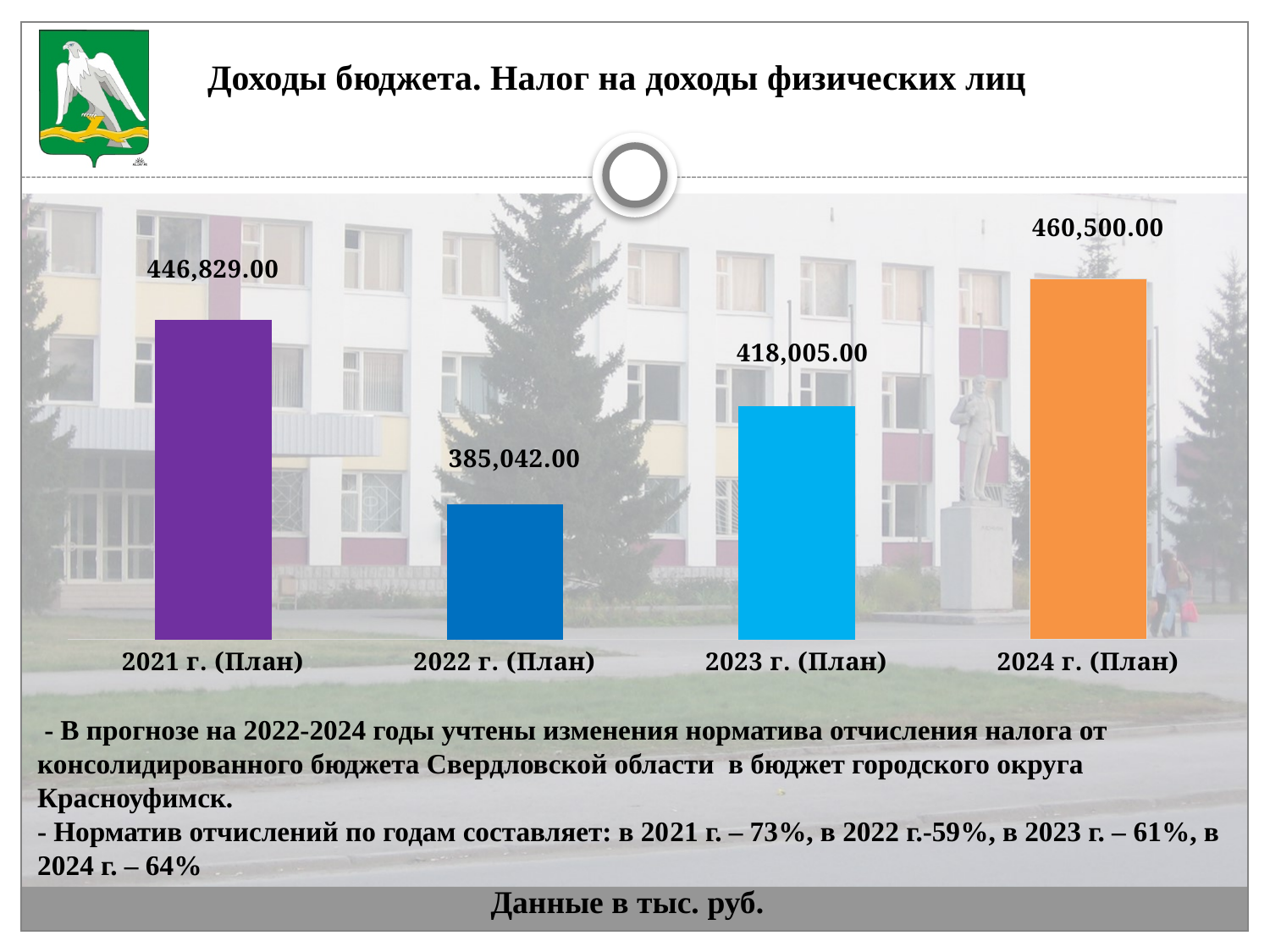
What is the difference between the values for 2024 г. (План) and 2021 г. (План)? 13,671.00 Which is larger, the value for 2021 г. (План) or 2023 г. (План)? 2021 г. (План) Which category has the lowest value? 2022 г. (План) What kind of chart is shown on the slide? Bar chart What is the value for 2024 г. (План)? 460,500.00 What is the difference between the values for 2023 г. (План) and 2022 г. (План)? 32,963.00 In what units are the chart's data given, according to the slide? тыс. руб. What is the value for 2023 г. (План)? 418,005.00 Which category has the highest value? 2024 г. (План) What is the value for 2022 г. (План)? 385,042.00 How many categories are shown in the chart? 4 What is the value for 2021 г. (План)? 446,829.00